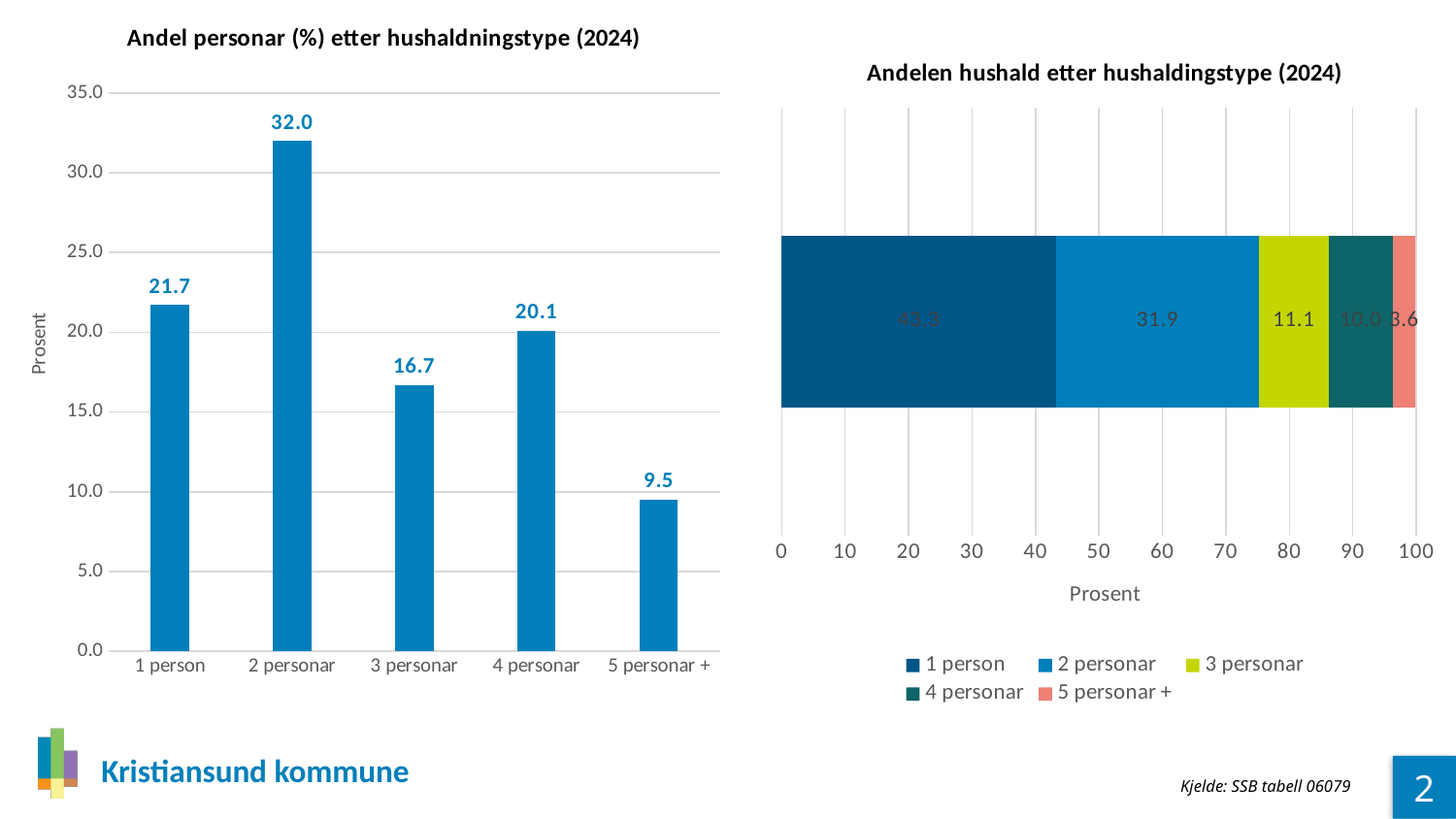
In the chart 'Andel personar (%) etter hushaldningstype (2024)', what is the value for 5 personar +? 9.5 In the chart 'Andelen hushald etter hushaldingstype (2024)', what is the value for 2 personar? 31.9 In the chart 'Andel personar (%) etter hushaldningstype (2024)', which category has the highest value? 2 personar What kind of chart is 'Andel personar (%) etter hushaldningstype (2024)'? bar chart In the chart 'Andelen hushald etter hushaldingstype (2024)', what is the value for 3 personar? 11.1 In the chart 'Andel personar (%) etter hushaldningstype (2024)', which category has the lowest value? 5 personar + In the chart 'Andel personar (%) etter hushaldningstype (2024)', what is the value for 2 personar? 32.0 In the chart 'Andelen hushald etter hushaldingstype (2024)', how many series does the legend list? 5 In the chart 'Andel personar (%) etter hushaldningstype (2024)', what is the difference between the values for 2 personar and 1 person? 10.3 In the chart 'Andelen hushald etter hushaldingstype (2024)', what is the label on the x axis? Prosent In the chart 'Andel personar (%) etter hushaldningstype (2024)', which is larger: the value for 1 person or the value for 4 personar? 1 person In the chart 'Andel personar (%) etter hushaldningstype (2024)', how many categories are shown on the x axis? 5